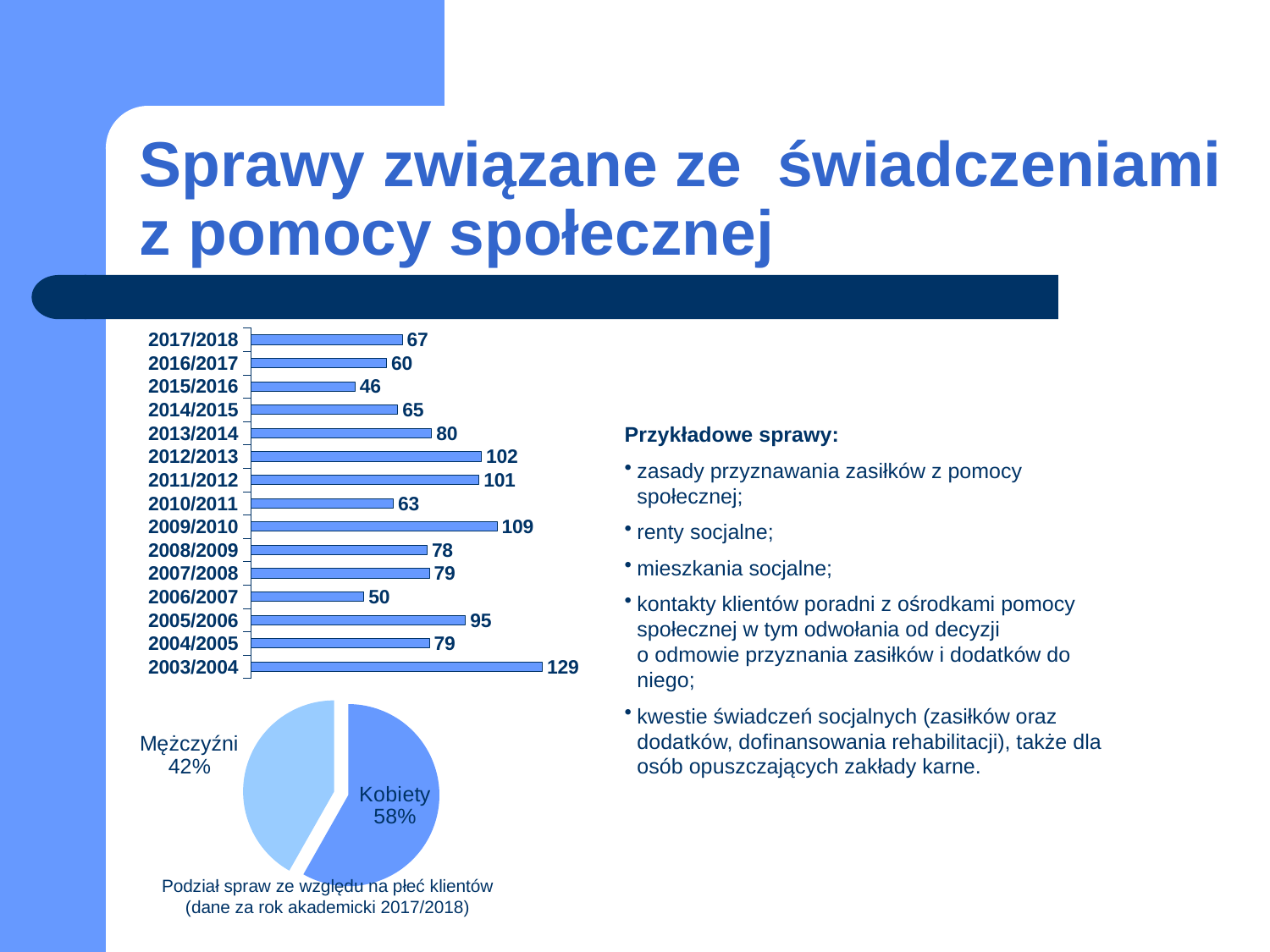
In the bar chart, which academic year has the highest value? 2003/2004 How many academic years are shown in the bar chart? 15 How many slices does the pie chart have? 2 What kind of chart is the upper chart on the slide? bar chart In the pie chart, what share is labelled Mężczyźni? 42% In the bar chart, what is the difference between the values for 2003/2004 and 2017/2018? 62 In the pie chart, what share is labelled Kobiety? 58% In the bar chart, what is the value for 2009/2010? 109 In the bar chart, what is the value for 2015/2016? 46 What is the caption below the pie chart? Podział spraw ze względu na płeć klientów (dane za rok akademicki 2017/2018) In the bar chart, which is larger: the value for 2012/2013 or the value for 2013/2014? 2012/2013 In the bar chart, which academic year has the lowest value? 2015/2016